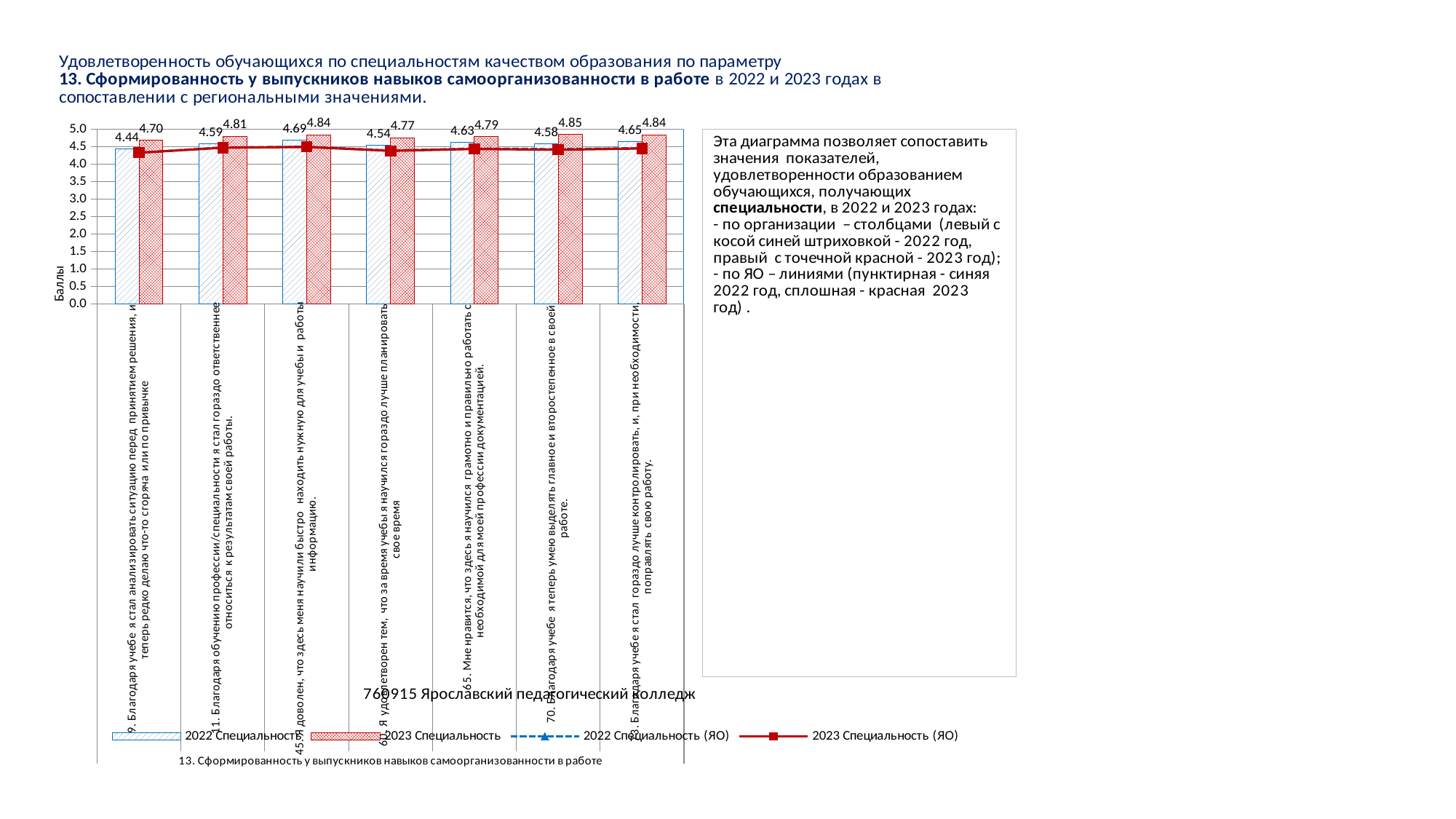
What is the value of the 2022 Специальность bar for category 45 (Я доволен, что здесь меня научили быстро находить нужную для учебы и работы информацию)? 4.69 What is the value of the 2022 Специальность bar for category 70 (Благодаря учебе я теперь умею выделять главное и второстепенное в своей работе)? 4.58 How many categories (questions) are shown on the x axis of the chart? 7 What is the value of the 2023 Специальность bar for category 9 (Благодаря учебе я стал анализировать ситуацию перед принятием решения)? 4.70 What is the difference between the 2023 and 2022 Специальность values for category 9? 0.26 What kind of chart is shown on the slide? Bar chart with line series Is the 2022 Специальность value for category 11 greater or less than 4.0? greater Which category has the highest 2023 Специальность value? 70. Благодаря учебе я теперь умею выделять главное и второстепенное в своей работе (4.85) Which category has the lowest 2022 Специальность value? 9. Благодаря учебе я стал анализировать ситуацию перед принятием решения (4.44) What is the title of the vertical axis of the chart? Баллы How many series does the chart legend list? 4